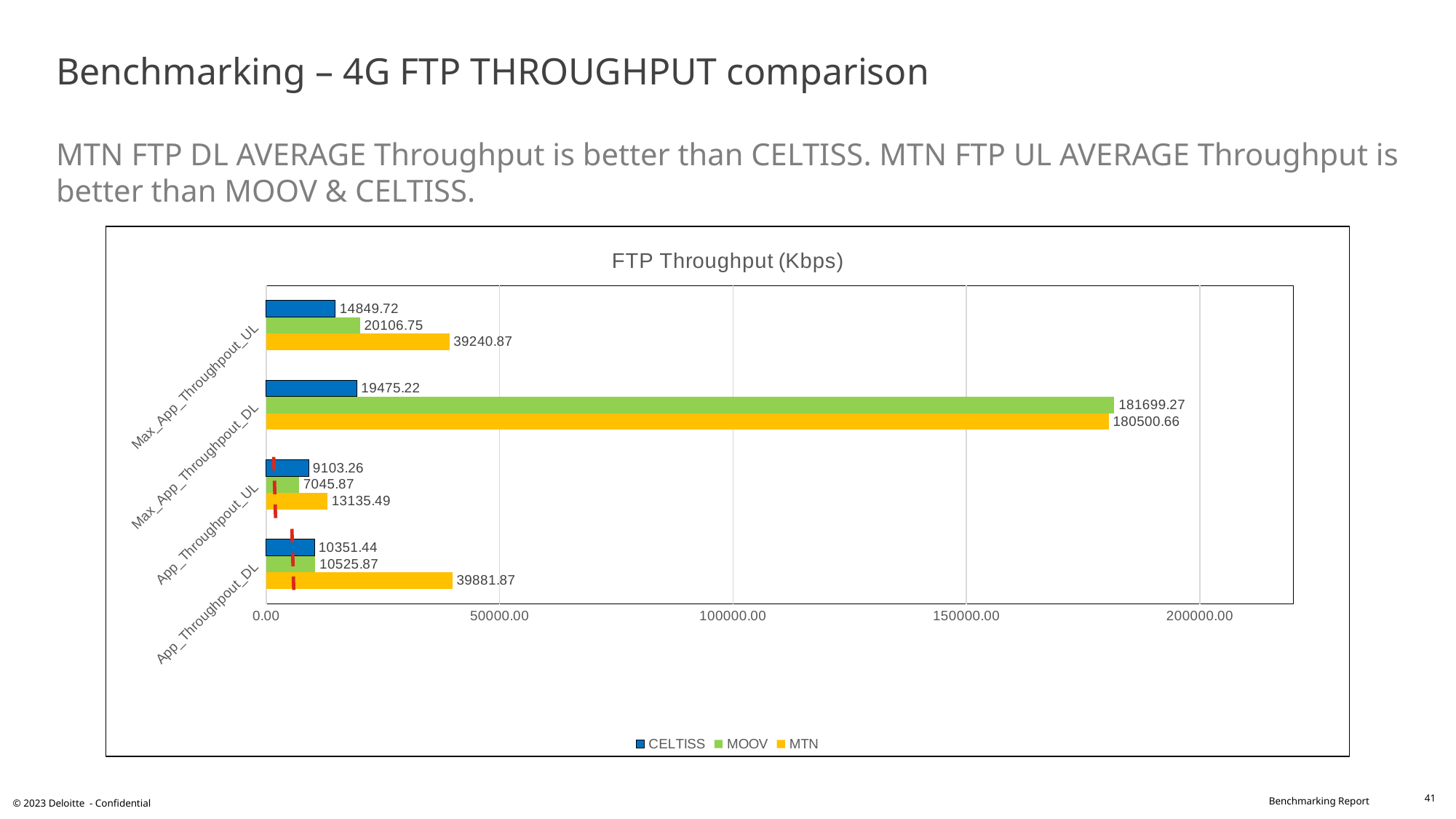
What is the MOOV value for Max_App_Throughpout_DL? 181699.27 Which series has the highest value for Max_App_Throughpout_DL? MOOV What type of chart is shown on the slide? Bar chart What is the MTN value for Max_App_Throughpout_UL? 39240.87 Which series has the lowest value for App_Throughpout_UL? MOOV Which is larger for Max_App_Throughpout_UL, the MOOV value or the CELTISS value? MOOV What is the MTN value for App_Throughpout_DL? 39881.87 Is the CELTISS value for Max_App_Throughpout_DL greater or less than 50000.00? less How many series does the legend list? 3 What is the difference between the MTN and CELTISS values for App_Throughpout_DL? 29530.43 What is the CELTISS value for App_Throughpout_UL? 9103.26 How many categories are shown on the chart? 4